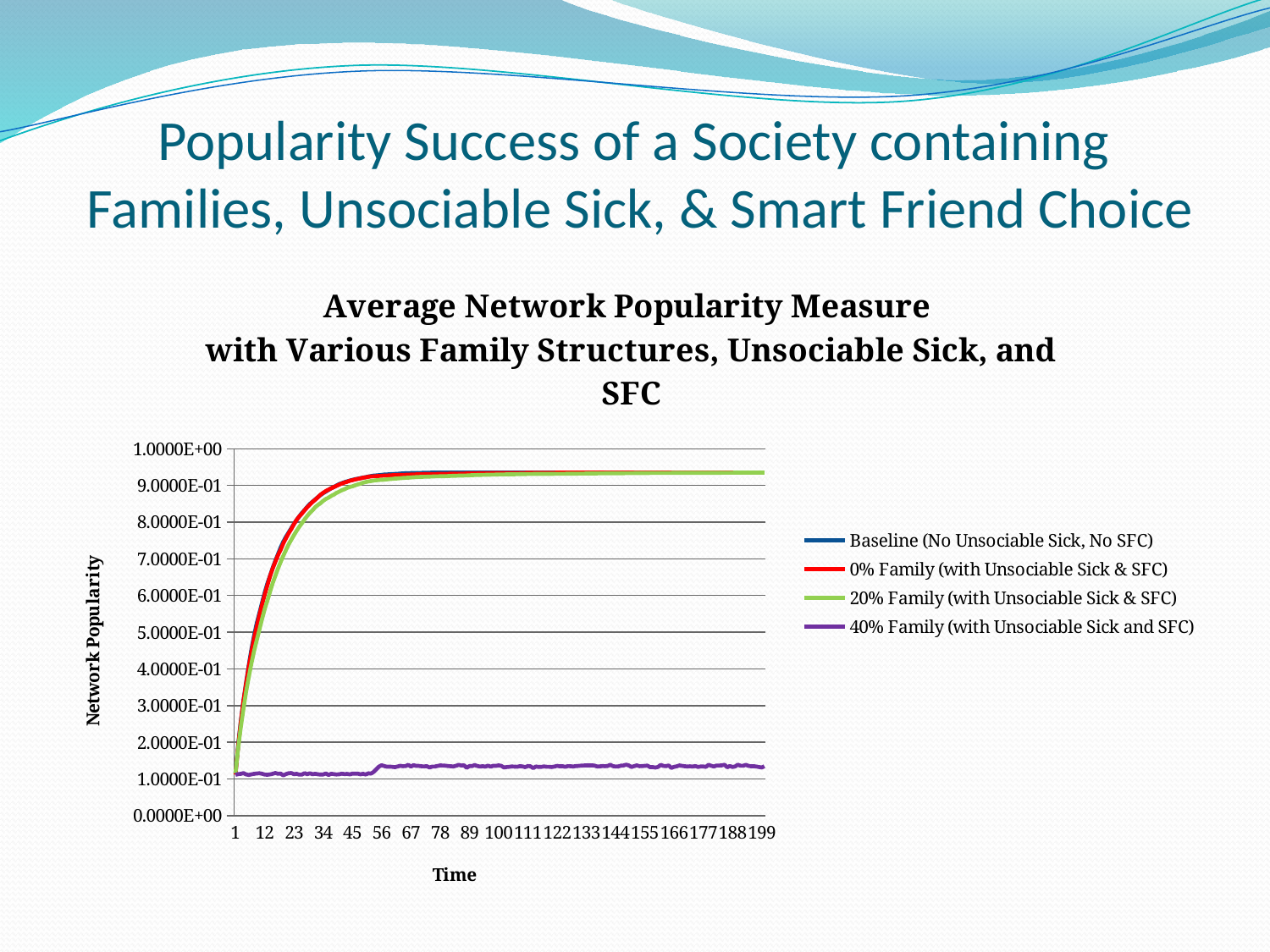
At time 199, which is larger: the Baseline (No Unsociable Sick, No SFC) series or the 40% Family (with Unsociable Sick and SFC) series? Baseline (No Unsociable Sick, No SFC) At time 150, which is larger: the 20% Family (with Unsociable Sick & SFC) series or the 40% Family (with Unsociable Sick and SFC) series? 20% Family (with Unsociable Sick & SFC) Is the value for the 40% Family (with Unsociable Sick and SFC) series at time 199 greater or less than 2.0000E-01? less Is the value for the 20% Family (with Unsociable Sick & SFC) series at time 100 greater or less than 8.0000E-01? greater Which series has the lowest network popularity at time 199? 40% Family (with Unsociable Sick and SFC) How many series does the legend list? 4 Is the value for the Baseline (No Unsociable Sick, No SFC) series at time 199 greater or less than 9.0000E-01? greater What is the title of the chart? Average Network Popularity Measure with Various Family Structures, Unsociable Sick, and SFC Does the 0% Family (with Unsociable Sick & SFC) series rise or fall between time 1 and time 56? rise What kind of chart is shown on the slide? line chart What is the highest tick value shown on the vertical axis? 1.0000E+00 What is the label of the vertical axis? Network Popularity